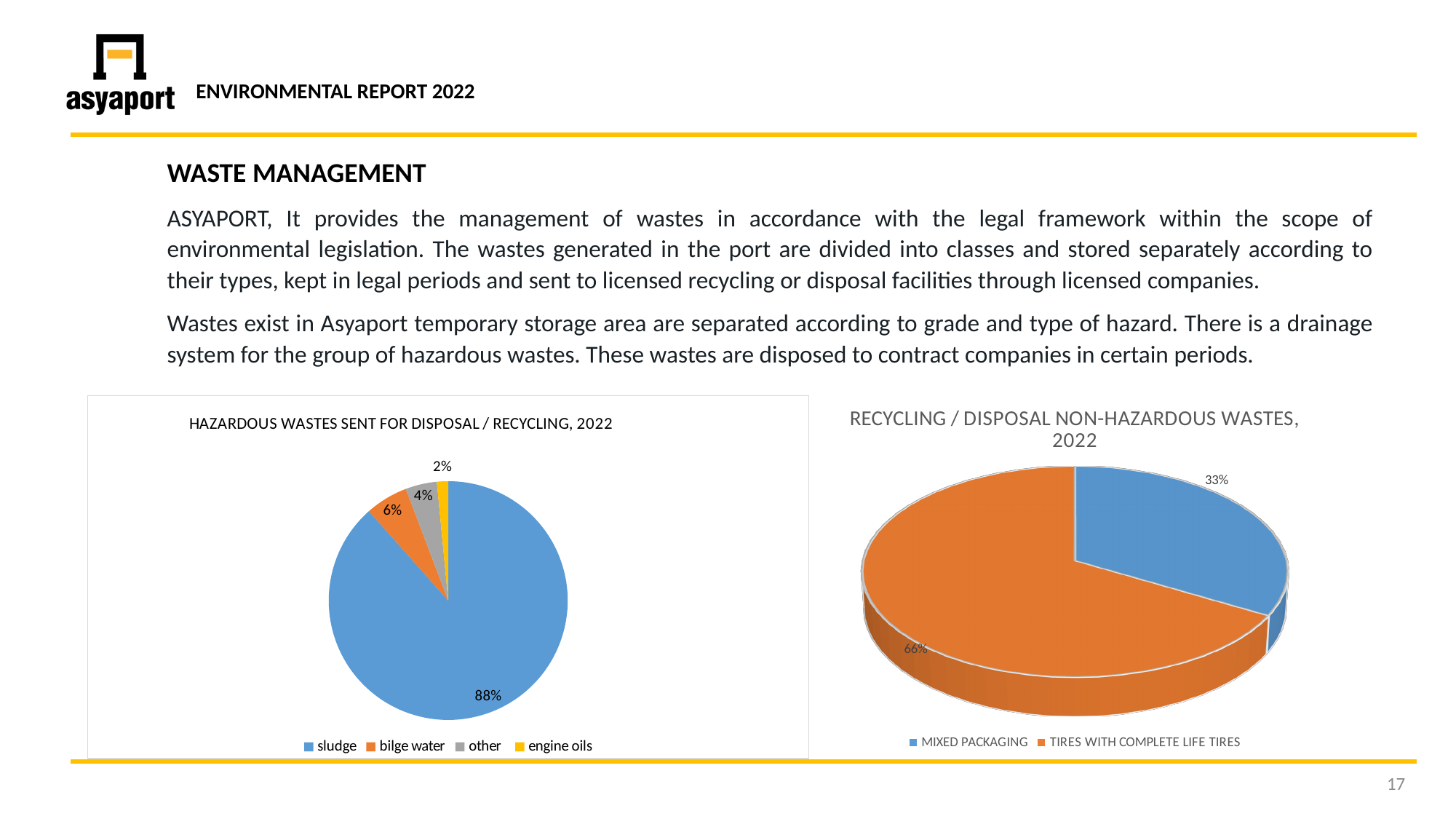
In the 'HAZARDOUS WASTES SENT FOR DISPOSAL / RECYCLING, 2022' chart, what share of the pie is engine oils? 2% In the 'HAZARDOUS WASTES SENT FOR DISPOSAL / RECYCLING, 2022' chart, which category has the smallest slice? engine oils In the 'HAZARDOUS WASTES SENT FOR DISPOSAL / RECYCLING, 2022' chart, what is the difference in percentage points between bilge water and other? 2 In the 'RECYCLING / DISPOSAL NON-HAZARDOUS WASTES, 2022' chart, what share of the pie is MIXED PACKAGING? 33% In the 'HAZARDOUS WASTES SENT FOR DISPOSAL / RECYCLING, 2022' chart, what share of the pie is bilge water? 6% In the 'HAZARDOUS WASTES SENT FOR DISPOSAL / RECYCLING, 2022' chart, what colour is the slice for other? grey In the 'RECYCLING / DISPOSAL NON-HAZARDOUS WASTES, 2022' chart, how many categories are shown? 2 In the 'RECYCLING / DISPOSAL NON-HAZARDOUS WASTES, 2022' chart, which category has the larger slice? TIRES WITH COMPLETE LIFE TIRES In the 'HAZARDOUS WASTES SENT FOR DISPOSAL / RECYCLING, 2022' chart, which category has the largest slice? sludge What kind of chart is the 'RECYCLING / DISPOSAL NON-HAZARDOUS WASTES, 2022' chart? pie chart In the 'HAZARDOUS WASTES SENT FOR DISPOSAL / RECYCLING, 2022' chart, how many categories does the legend list? 4